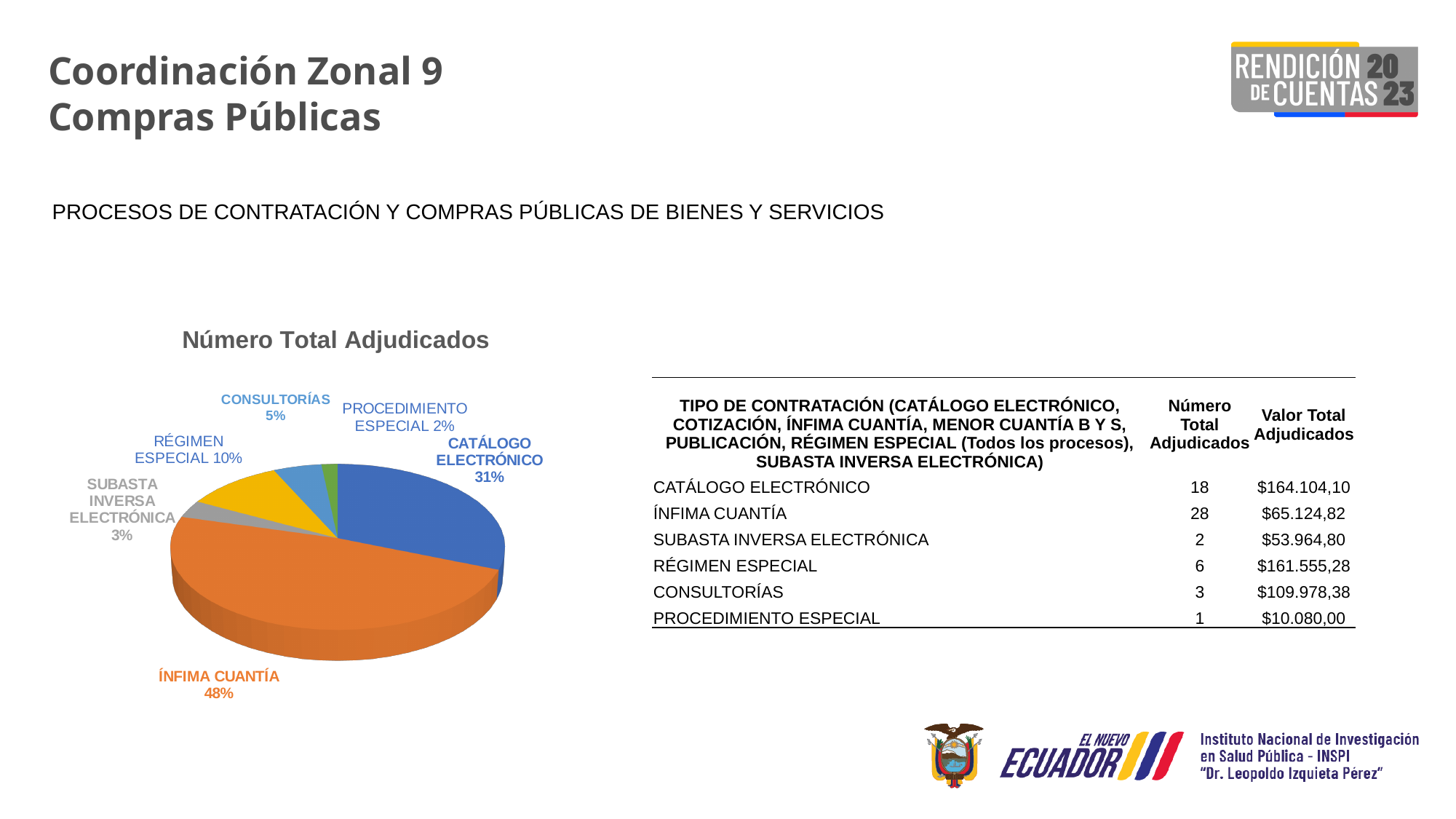
What share of the pie does CONSULTORÍAS represent? 5% What is the difference in percentage points between the ÍNFIMA CUANTÍA and CATÁLOGO ELECTRÓNICO slices? 17% What share of the pie does CATÁLOGO ELECTRÓNICO represent? 31% Which category has the smallest slice of the pie? PROCEDIMIENTO ESPECIAL What share of the pie does ÍNFIMA CUANTÍA represent? 48% How many slices does the pie chart have? 6 What is the title of the chart? Número Total Adjudicados Which category has the largest slice of the pie? ÍNFIMA CUANTÍA What type of chart is shown on the slide? pie chart